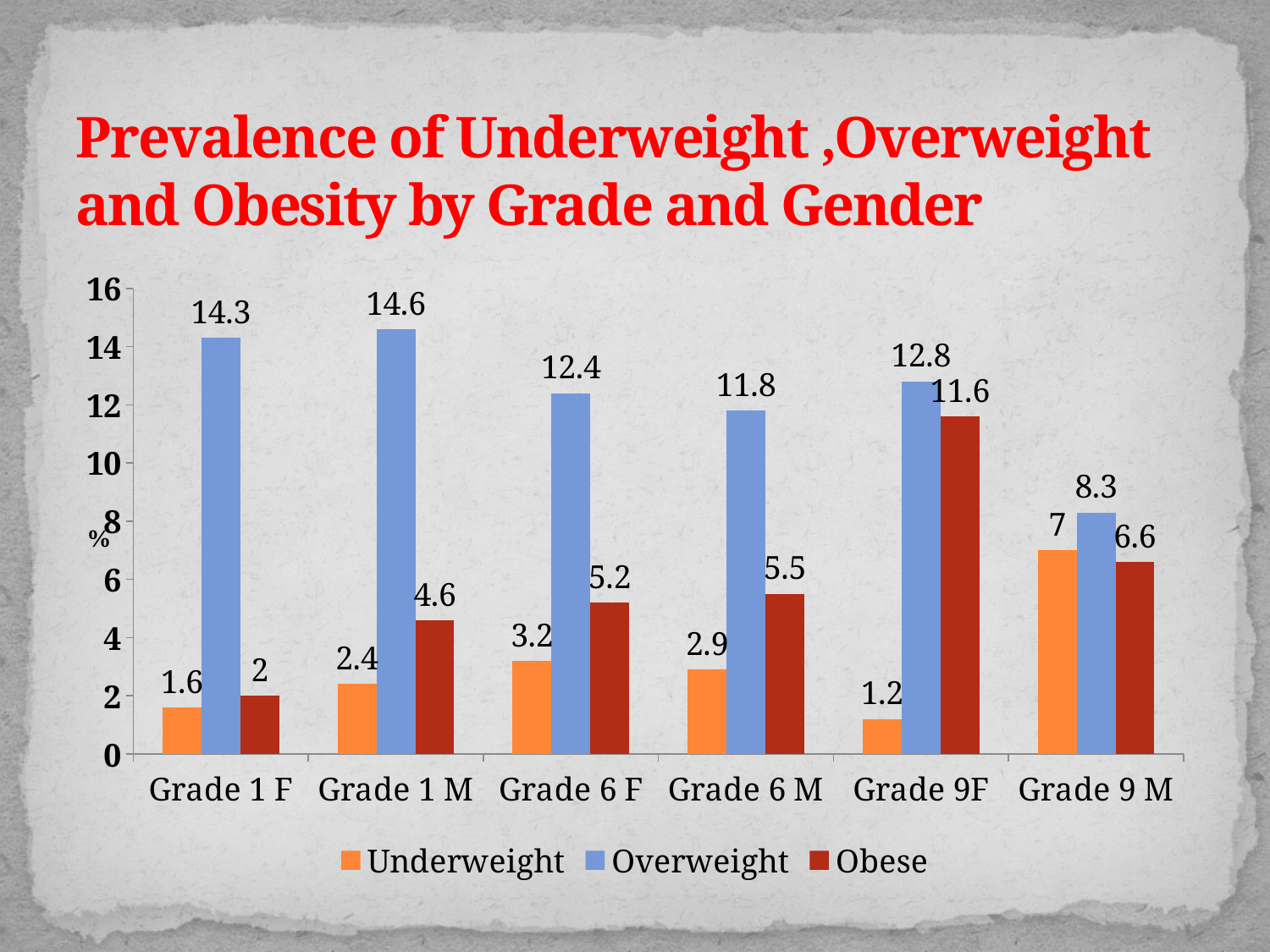
How many series does the legend list? 3 Which category has the highest Obese value? Grade 9F What is the Underweight value for Grade 9F? 1.2 Does the Underweight value rise or fall from Grade 1 F to Grade 6 F? Rise What is the difference between the Overweight and Obese values for Grade 1 F? 12.3 What is the title of the chart? Prevalence of Underweight ,Overweight and Obesity by Grade and Gender Which is larger, the Underweight value for Grade 9 M or the Obese value for Grade 9 M? Underweight (7) What kind of chart is shown on the slide? Bar chart What is the Obese value for Grade 6 M? 5.5 How many categories are shown on the x axis? 6 What is the Overweight value for Grade 1 M? 14.6 Which category has the lowest Overweight value? Grade 9 M